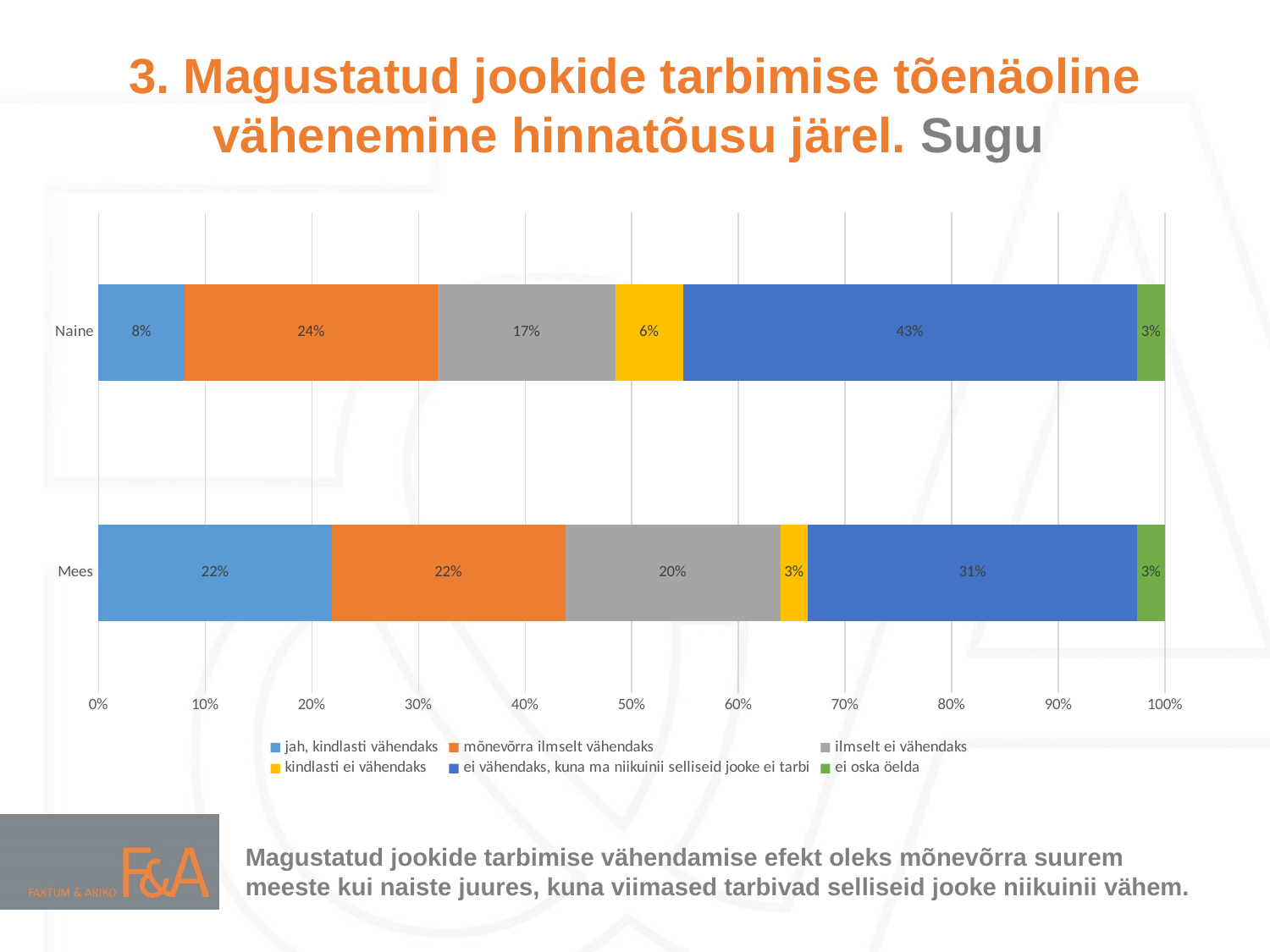
What is the value of 'jah, kindlasti vähendaks' for Naine? 8% How many series does the legend list? 6 What is the value of 'ei vähendaks, kuna ma niikuinii selliseid jooke ei tarbi' for Naine? 43% Which series has the largest value in the Naine bar? ei vähendaks, kuna ma niikuinii selliseid jooke ei tarbi How many categories are plotted on the chart? 2 What is the value of 'jah, kindlasti vähendaks' for Mees? 22% Which category has the higher value for 'ei vähendaks, kuna ma niikuinii selliseid jooke ei tarbi', Naine or Mees? Naine What is the difference between the 'ilmselt ei vähendaks' values for Mees and Naine? 3% What is the difference between the 'jah, kindlasti vähendaks' values for Mees and Naine? 14% Which category label appears at the top of the chart? Naine What kind of chart is shown on the slide? stacked bar chart What is the value of 'kindlasti ei vähendaks' for Mees? 3%